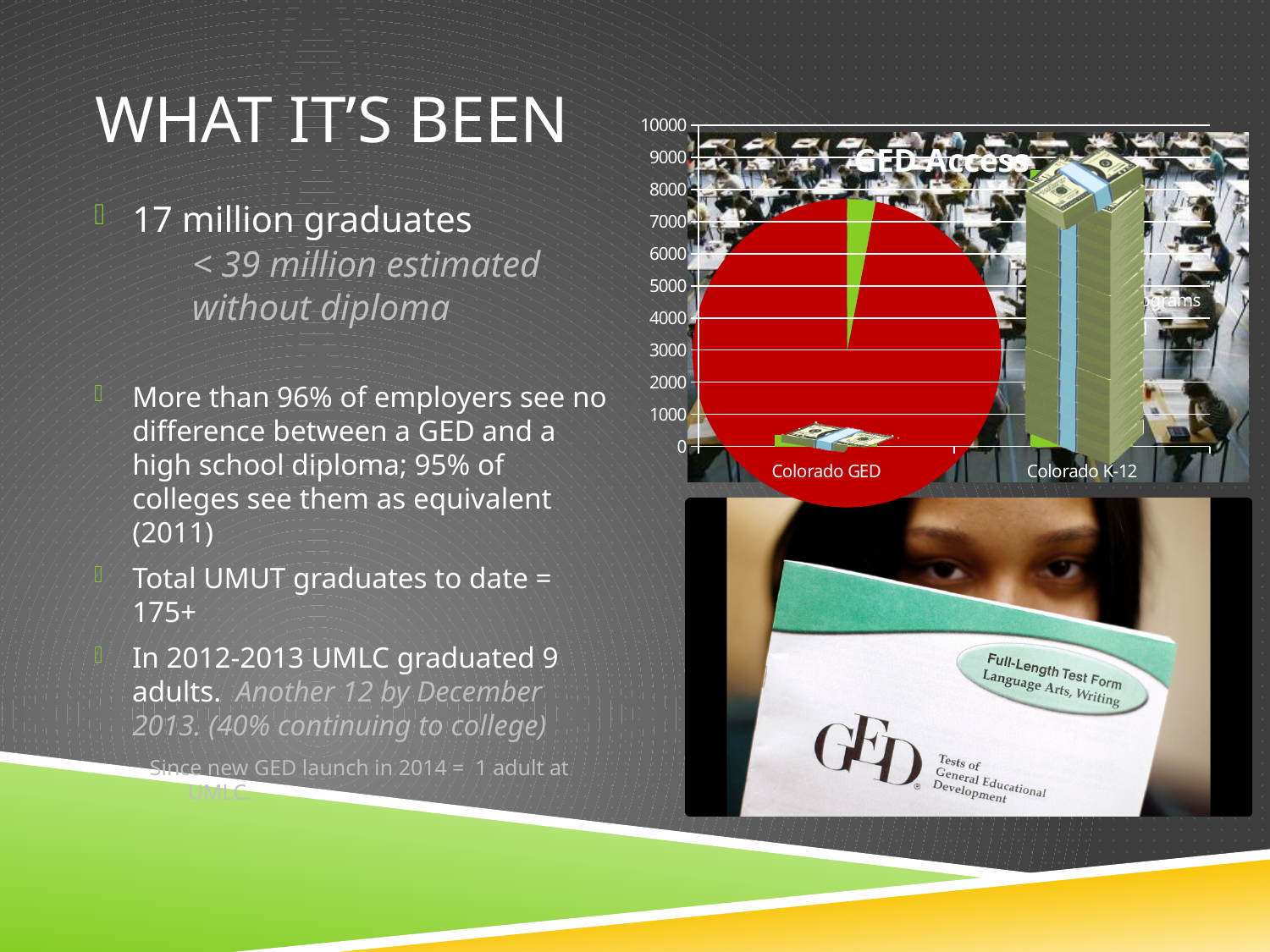
What is the title of the chart on the right side of the slide? GED Access In the pie chart overlaid on the GED Access chart, which colour slice is larger, red or green? red In the GED Access chart, is the value for Colorado K-12 greater or less than 5000? greater In the GED Access chart, which category has the highest bar? Colorado K-12 In the GED Access chart, which category has the taller bar, Colorado GED or Colorado K-12? Colorado K-12 What is the maximum value shown on the vertical axis of the GED Access chart? 10000 In the GED Access chart, how many categories are shown on the x axis? 2 In the GED Access chart, is the value for Colorado GED greater or less than 2000? less In the GED Access chart, which category has the lowest bar? Colorado GED